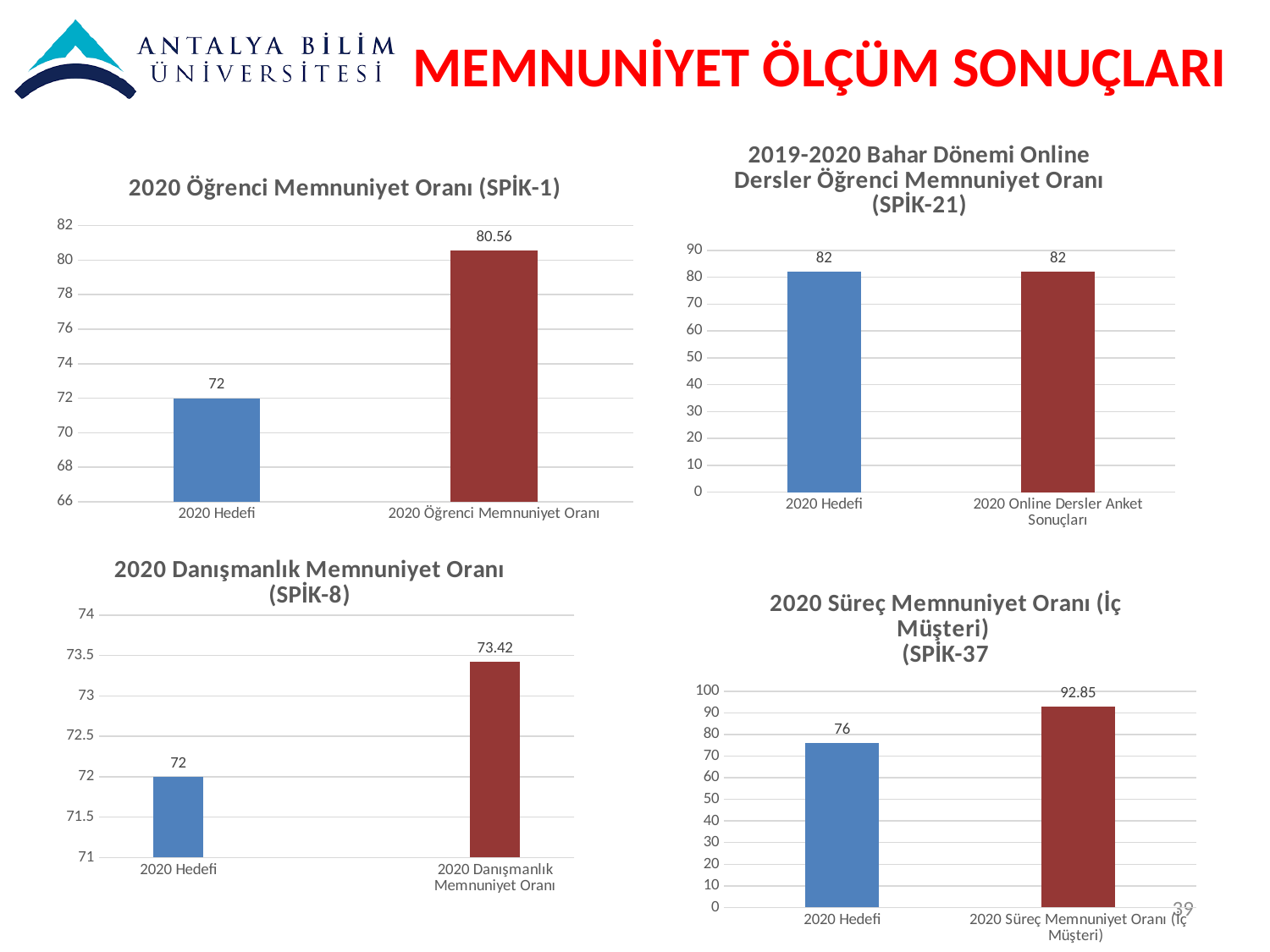
How many bars are plotted in the chart titled "2020 Öğrenci Memnuniyet Oranı (SPİK-1)"? 2 What type of chart is the chart titled "2020 Danışmanlık Memnuniyet Oranı (SPİK-8)"? Bar chart In the chart titled "2020 Süreç Memnuniyet Oranı (İç Müşteri) (SPİK-37)", what is the value for 2020 Süreç Memnuniyet Oranı (İç Müşteri)? 92.85 In the chart titled "2020 Danışmanlık Memnuniyet Oranı (SPİK-8)", what is the value for 2020 Danışmanlık Memnuniyet Oranı? 73.42 In the chart titled "2020 Danışmanlık Memnuniyet Oranı (SPİK-8)", which category has the higher value? 2020 Danışmanlık Memnuniyet Oranı In the chart titled "2020 Süreç Memnuniyet Oranı (İç Müşteri) (SPİK-37)", what is the value for 2020 Hedefi? 76 In the chart titled "2019-2020 Bahar Dönemi Online Dersler Öğrenci Memnuniyet Oranı (SPİK-21)", what is the value for 2020 Online Dersler Anket Sonuçları? 82 In the chart titled "2020 Öğrenci Memnuniyet Oranı (SPİK-1)", what is the difference between 2020 Öğrenci Memnuniyet Oranı and 2020 Hedefi? 8.56 In the chart titled "2020 Süreç Memnuniyet Oranı (İç Müşteri) (SPİK-37)", which category has the lower value? 2020 Hedefi In the chart titled "2020 Öğrenci Memnuniyet Oranı (SPİK-1)", what is the value for 2020 Öğrenci Memnuniyet Oranı? 80.56 In the chart titled "2019-2020 Bahar Dönemi Online Dersler Öğrenci Memnuniyet Oranı (SPİK-21)", what is the difference between 2020 Hedefi and 2020 Online Dersler Anket Sonuçları? 0 In the chart titled "2020 Öğrenci Memnuniyet Oranı (SPİK-1)", what is the value for 2020 Hedefi? 72